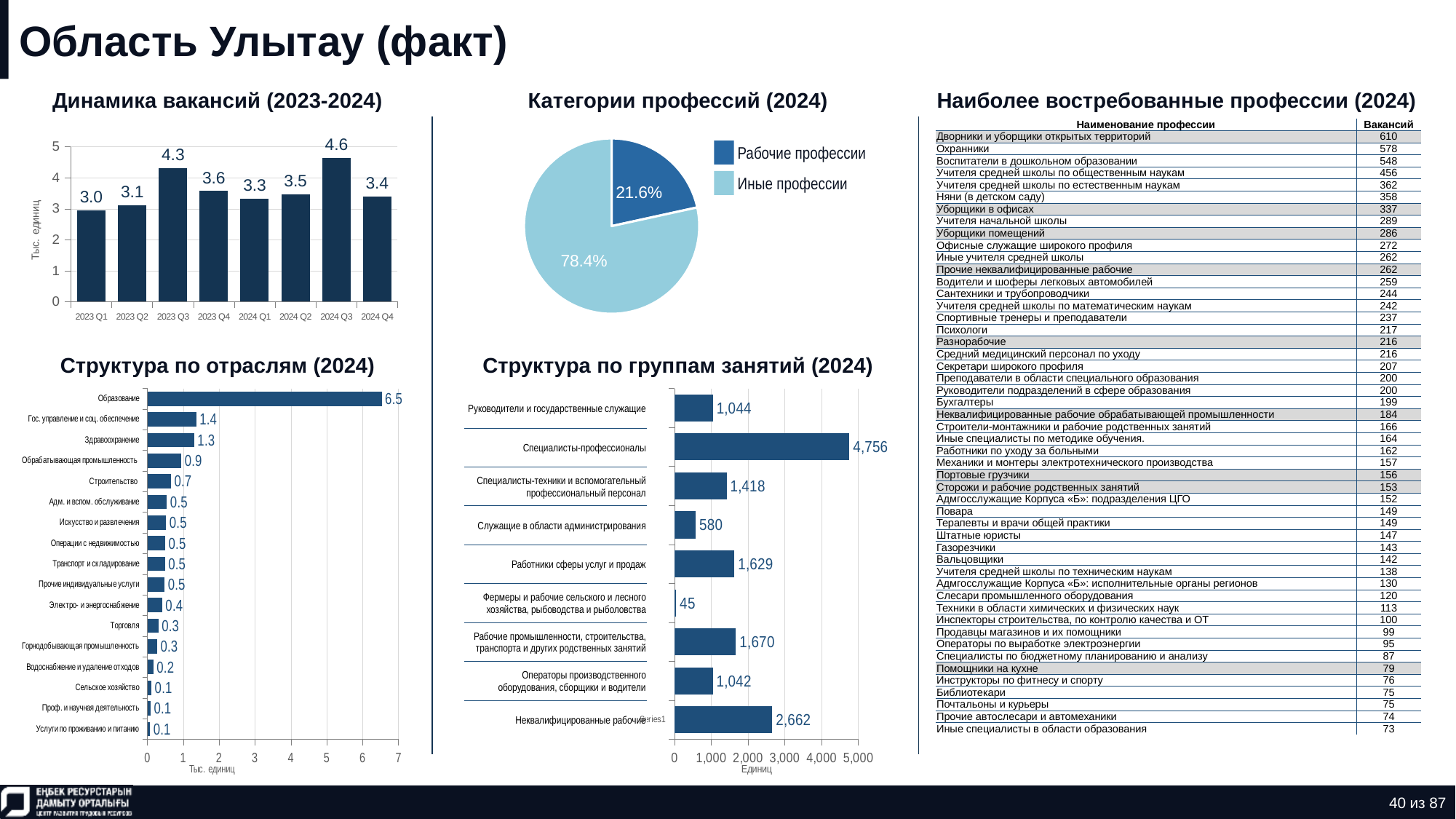
In the chart 'Структура по отраслям (2024)', which is larger: 'Гос. управление и соц. обеспечение' or 'Здравоохранение'? Гос. управление и соц. обеспечение What kind of chart is 'Категории профессий (2024)'? pie chart In the chart 'Структура по отраслям (2024)', what is the value for 'Образование'? 6.5 In the chart 'Динамика вакансий (2023-2024)', which quarter has the lowest value? 2023 Q1 How many quarters are shown in the chart 'Динамика вакансий (2023-2024)'? 8 In the chart 'Динамика вакансий (2023-2024)', which quarter has the highest value? 2024 Q3 In the chart 'Структура по группам занятий (2024)', what is the difference between 'Неквалифицированные рабочие' and 'Служащие в области администрирования'? 2,082 How many entries does the legend of the chart 'Категории профессий (2024)' list? 2 In the chart 'Динамика вакансий (2023-2024)', what is the value for 2024 Q3? 4.6 In the pie chart 'Категории профессий (2024)', what share does 'Рабочие профессии' have? 21.6% In the chart 'Структура по группам занятий (2024)', which category has the highest value? Специалисты-профессионалы In the chart 'Динамика вакансий (2023-2024)', what is the difference between the values for 2023 Q3 and 2023 Q1? 1.3